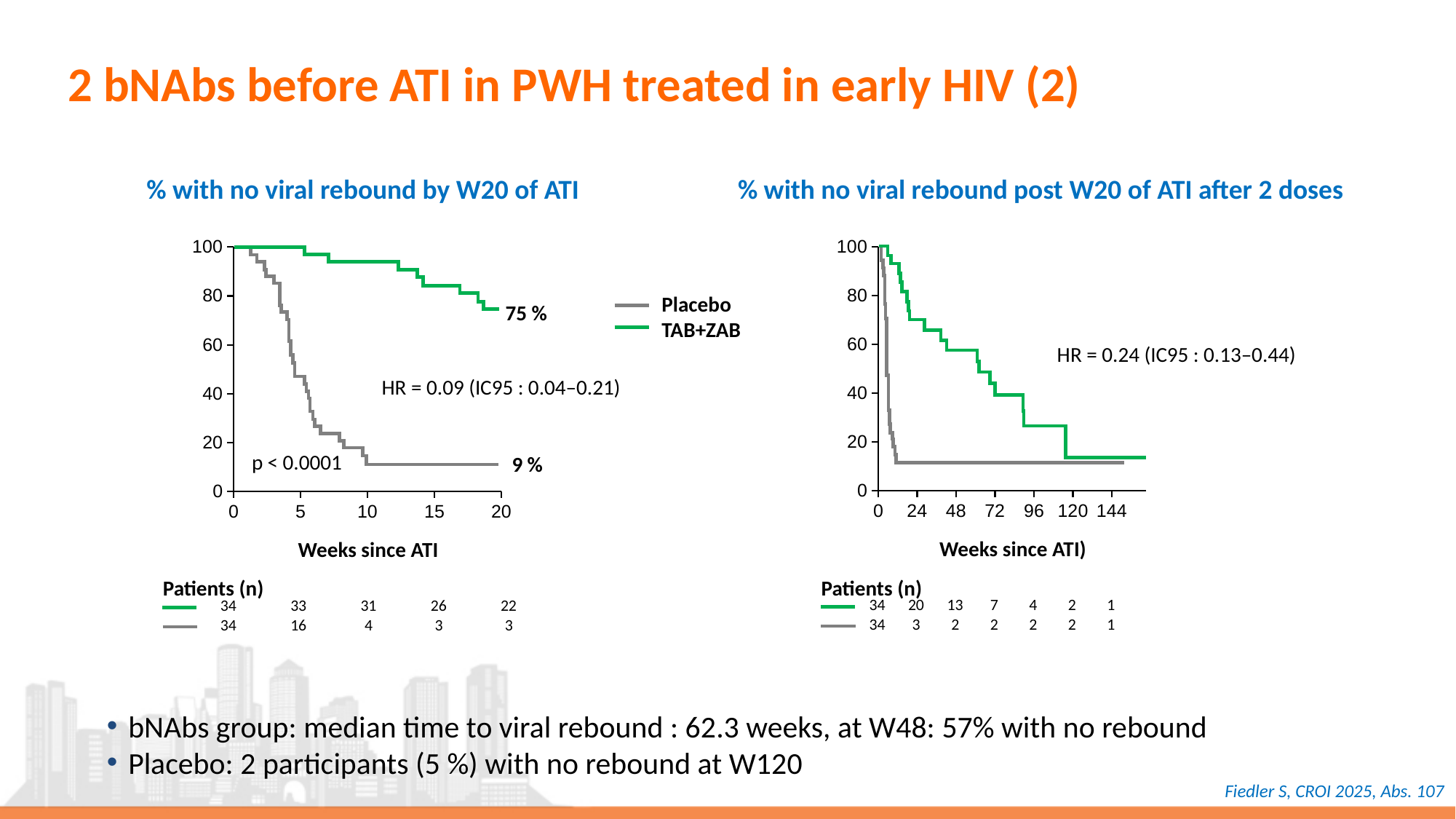
In the right chart (% with no viral rebound post W20 of ATI after 2 doses), what hazard ratio is printed on the chart? HR = 0.24 (IC95 : 0.13–0.44) In the left chart (% with no viral rebound by W20 of ATI), what hazard ratio is printed on the chart? HR = 0.09 (IC95 : 0.04–0.21) In the left chart (% with no viral rebound by W20 of ATI), how many Placebo patients are listed at risk at week 10 in the Patients (n) table? 4 What kind of chart is the left chart (% with no viral rebound by W20 of ATI)? line chart In the left chart (% with no viral rebound by W20 of ATI), what percentage of the Placebo group had no viral rebound at week 20? 9 % In the right chart (% with no viral rebound post W20 of ATI after 2 doses), is the Placebo value at week 24 greater or less than 20? less In the left chart (% with no viral rebound by W20 of ATI), which group has the higher percentage with no viral rebound at week 20? TAB+ZAB In the left chart (% with no viral rebound by W20 of ATI), what is the difference between the TAB+ZAB and Placebo percentages labelled at week 20? 66 % In the left chart (% with no viral rebound by W20 of ATI), what percentage of the TAB+ZAB group had no viral rebound at week 20? 75 % In the right chart (% with no viral rebound post W20 of ATI after 2 doses), is the TAB+ZAB value at week 48 greater or less than 40? greater In the left chart (% with no viral rebound by W20 of ATI), does the Placebo curve rise or fall as weeks since ATI increase? fall How many series does the legend of the left chart list? 2